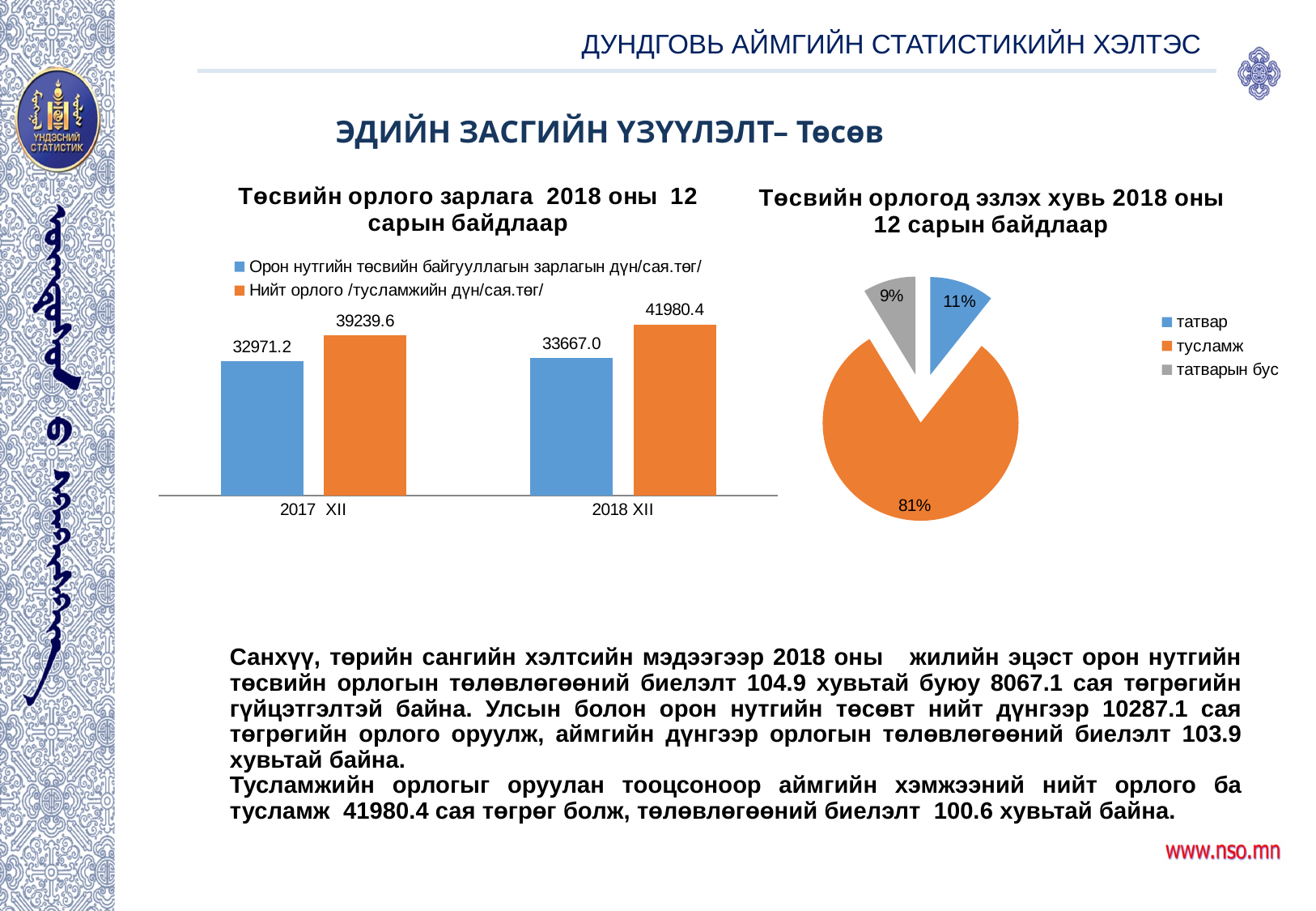
What kind of chart is the chart on the right of the slide? pie chart In the pie chart on the right, what share does 'тусламж' have? 81% In the left bar chart, which is larger for 2017 XII: 'Нийт орлого' or 'зарлагын дүн'? Нийт орлого In the left bar chart, what is the value of 'Орон нутгийн төсвийн байгууллагын зарлагын дүн/сая.төг/' for 2018 XII? 33667.0 In the pie chart on the right, which category has the smallest share? татварын бус In the left bar chart, how many series does the legend list? 2 In the left bar chart, what is the value of 'Орон нутгийн төсвийн байгууллагын зарлагын дүн/сая.төг/' for 2017 XII? 32971.2 In the left bar chart, does 'Нийт орлого' rise or fall from 2017 XII to 2018 XII? rise In the left bar chart, what is the value of 'Нийт орлого /тусламжийн дүн/сая.төг/' for 2018 XII? 41980.4 In the left bar chart, what is the difference between 'Нийт орлого' and 'зарлагын дүн' for 2018 XII? 8313.4 In the pie chart on the right, how many slices are there? 3 In the pie chart on the right, what colour is the 'татвар' slice? blue